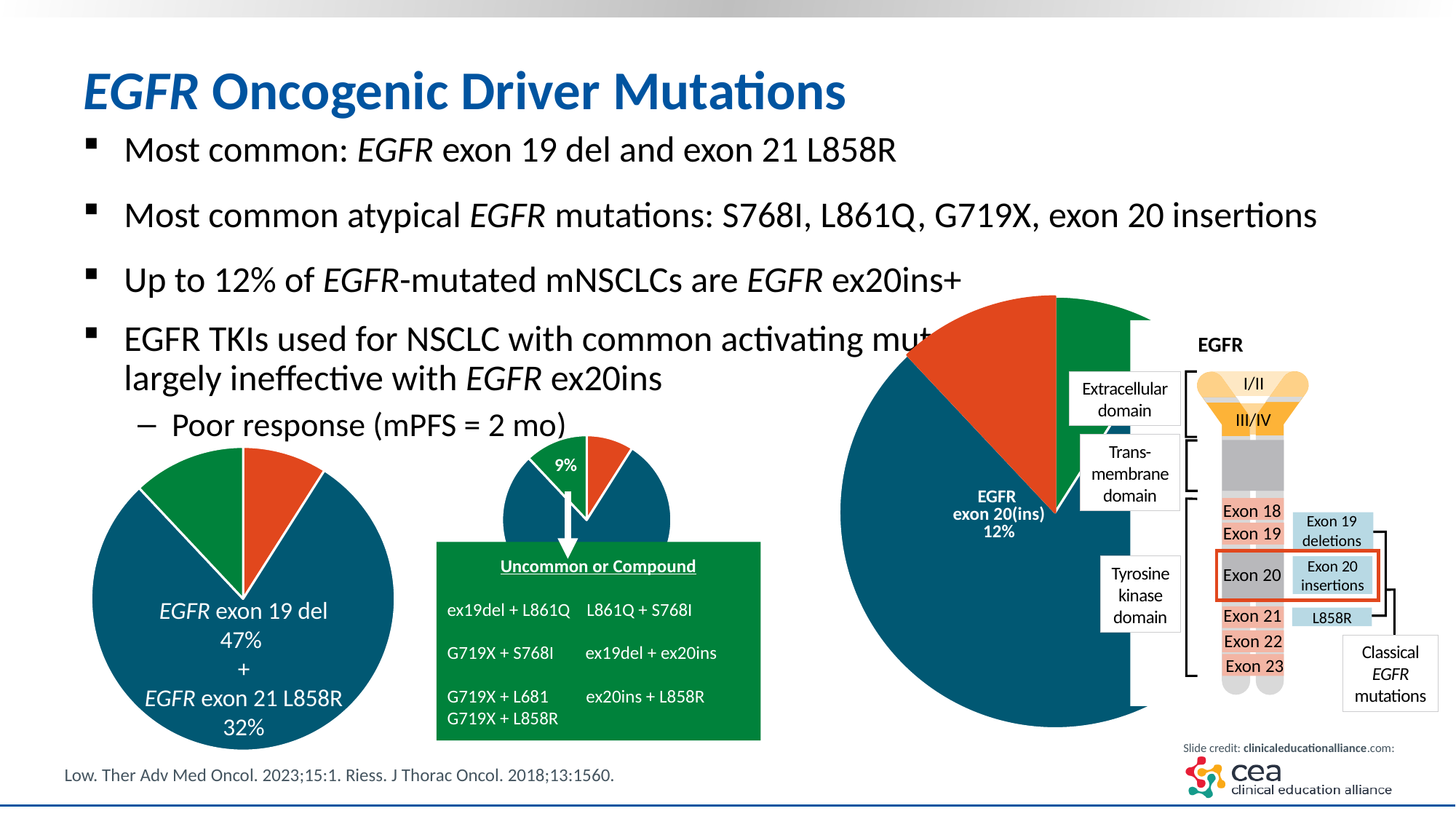
In the middle (small) pie chart, what percentage is printed on the green slice? 9% In the right pie chart, is the blue slice larger or smaller than the EGFR exon 20(ins) 12% slice? Larger In the left pie chart, which slice is the largest? The blue slice (EGFR exon 19 del + EGFR exon 21 L858R) In the left pie chart, what percentage is shown for EGFR exon 19 del? 47% How many slices does the left pie chart have? 3 In the right pie chart, what percentage is shown for EGFR exon 20(ins)? 12% How many pie charts are shown on the slide? 3 What is the underlined heading of the green box below the middle pie chart? Uncommon or Compound What kind of chart is used to show the EGFR mutation proportions on this slide? Pie chart In the left pie chart, what is the difference between the EGFR exon 19 del percentage and the EGFR exon 21 L858R percentage? 15% In the left pie chart, which has the larger percentage: EGFR exon 19 del or EGFR exon 21 L858R? EGFR exon 19 del In the left pie chart, what percentage is shown for EGFR exon 21 L858R? 32%